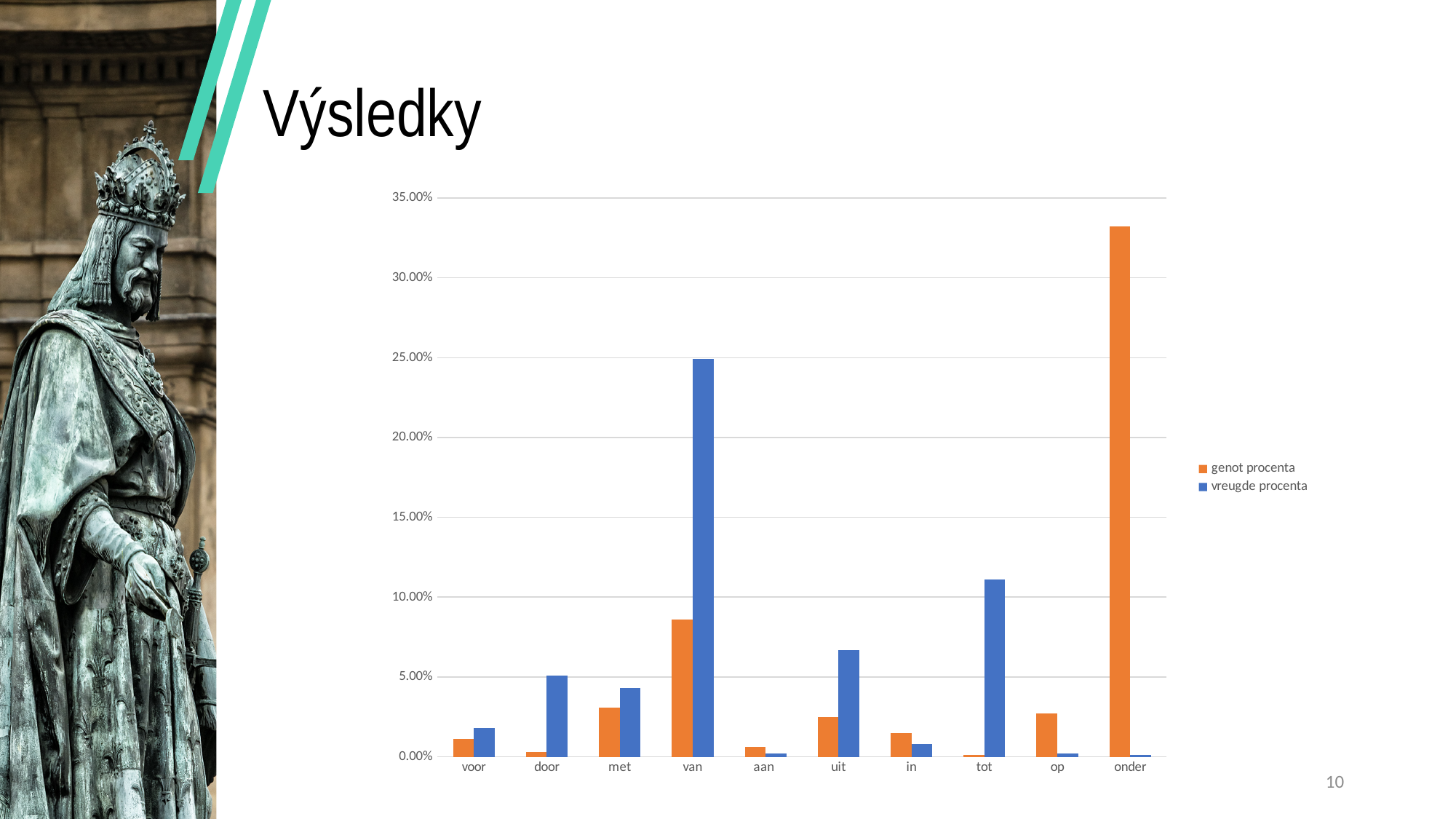
Is the genot procenta value for van greater or less than 10.00%? less How many categories are shown on the x axis of the chart? 10 How many series does the chart's legend list? 2 Is the genot procenta value for onder greater or less than 30.00%? greater For the category van, which series has the larger value, genot procenta or vreugde procenta? vreugde procenta Is the vreugde procenta value for van greater or less than 20.00%? greater Which category has the highest value for the genot procenta series? onder Which category has the highest value for the vreugde procenta series? van What kind of chart is shown on the slide? bar chart For the category onder, which series has the larger value, genot procenta or vreugde procenta? genot procenta Which colour represents the vreugde procenta series in the chart? blue